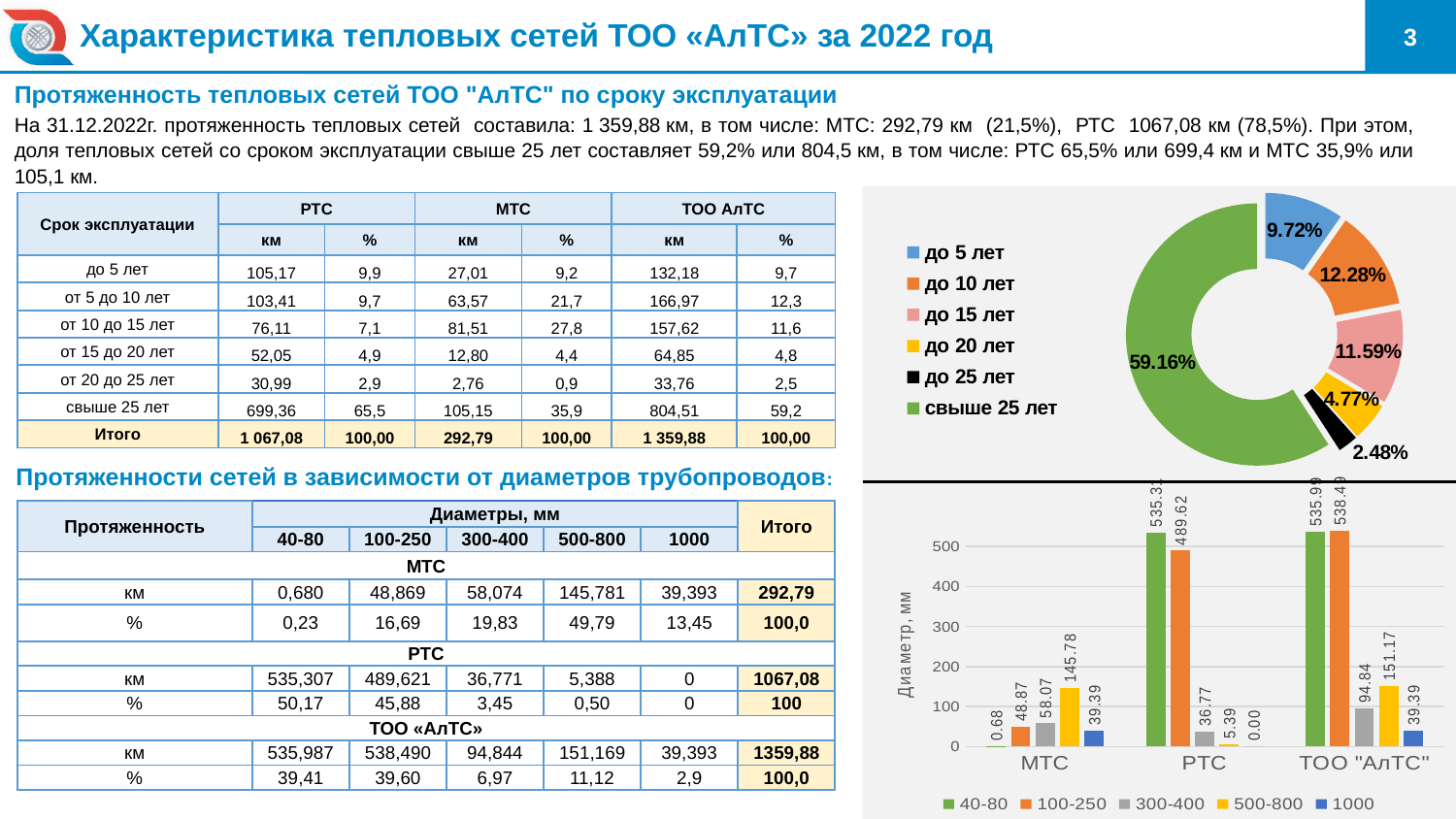
In the pie chart, what share is shown for the segment 'свыше 25 лет'? 59.16% In the bar chart, is the 300-400 value for ТОО "АлТС" greater or less than 100? less In the pie chart, which segment has the smallest share? до 25 лет In the pie chart, what share is shown for the segment 'до 5 лет'? 9.72% In the bar chart, what is the difference between the 100-250 value for ТОО "АлТС" and the 100-250 value for РТС? 48.87 In the bar chart, how many series does the legend list? 5 What type of chart is the chart at the bottom right of the slide? bar chart In the bar chart, what is the value of the 500-800 series for МТС? 145.78 In the pie chart, how many segments does the legend list? 6 In the pie chart, which is larger: the share for 'до 10 лет' or the share for 'до 20 лет'? до 10 лет In the bar chart, which series has the highest value for ТОО "АлТС"? 100-250 In the bar chart, what is the value of the 40-80 series for РТС? 535.31